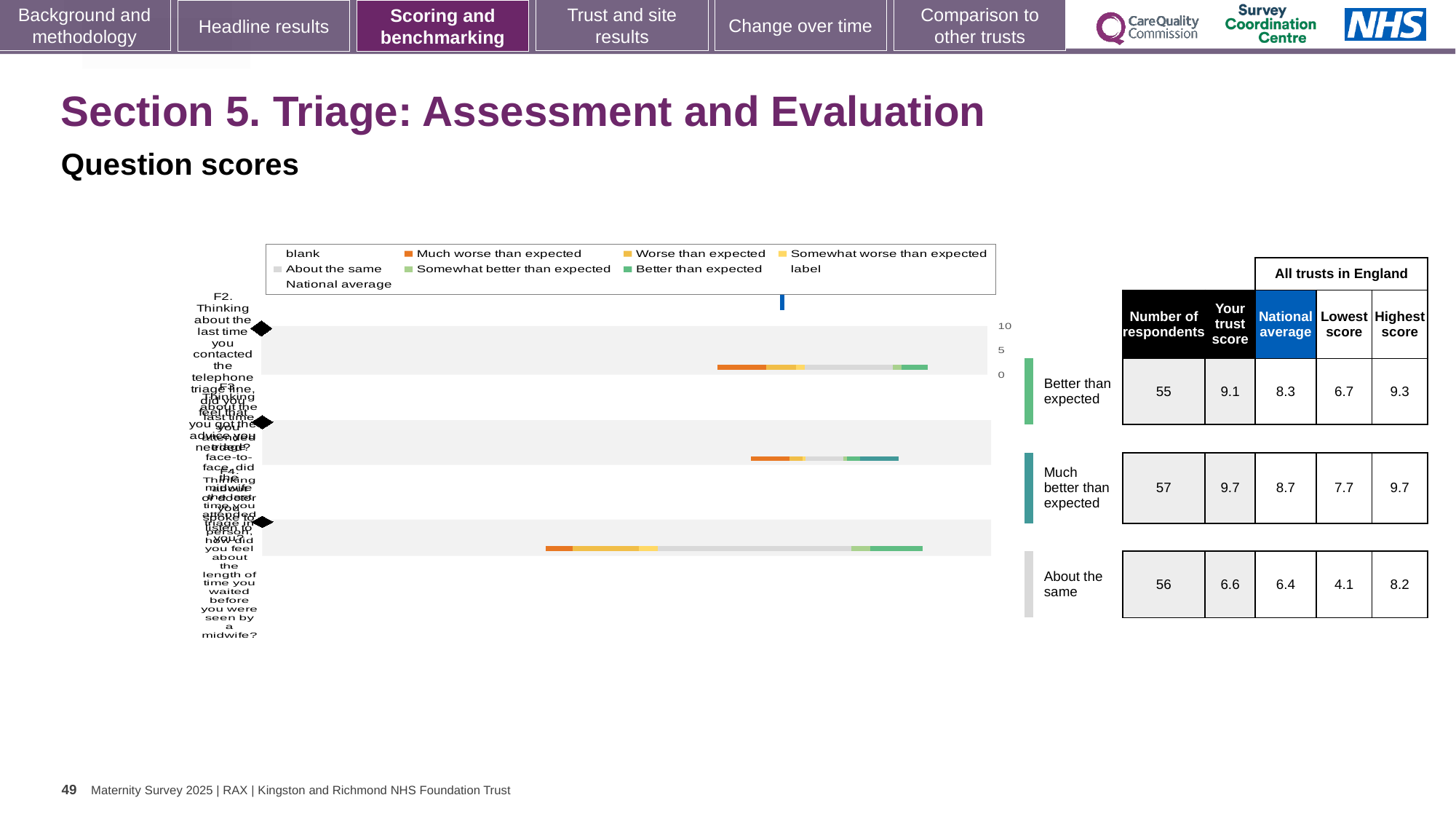
In the chart legend, what colour represents "Much worse than expected"? orange In the table on the right, what is the difference between "Your trust score" and the National average for the row labelled "About the same"? 0.2 How many question bars are plotted in the chart? 3 In the table on the right, which row has the highest "Your trust score"? Much better than expected In the table on the right, for the row labelled "Much better than expected", which is larger: "Your trust score" or the National average? Your trust score In the table on the right, what is "Your trust score" for the row labelled "Better than expected"? 9.1 In the table on the right, which row has the lowest "Lowest score"? About the same In the table on the right, what is the Highest score for the row labelled "Better than expected"? 9.3 In the table on the right, what is the Number of respondents for the row labelled "About the same"? 56 In the chart legend, what colour represents "Better than expected"? green What kind of chart is shown on the left of the slide? bar chart In the table on the right, what is the National average for the row labelled "Much better than expected"? 8.7